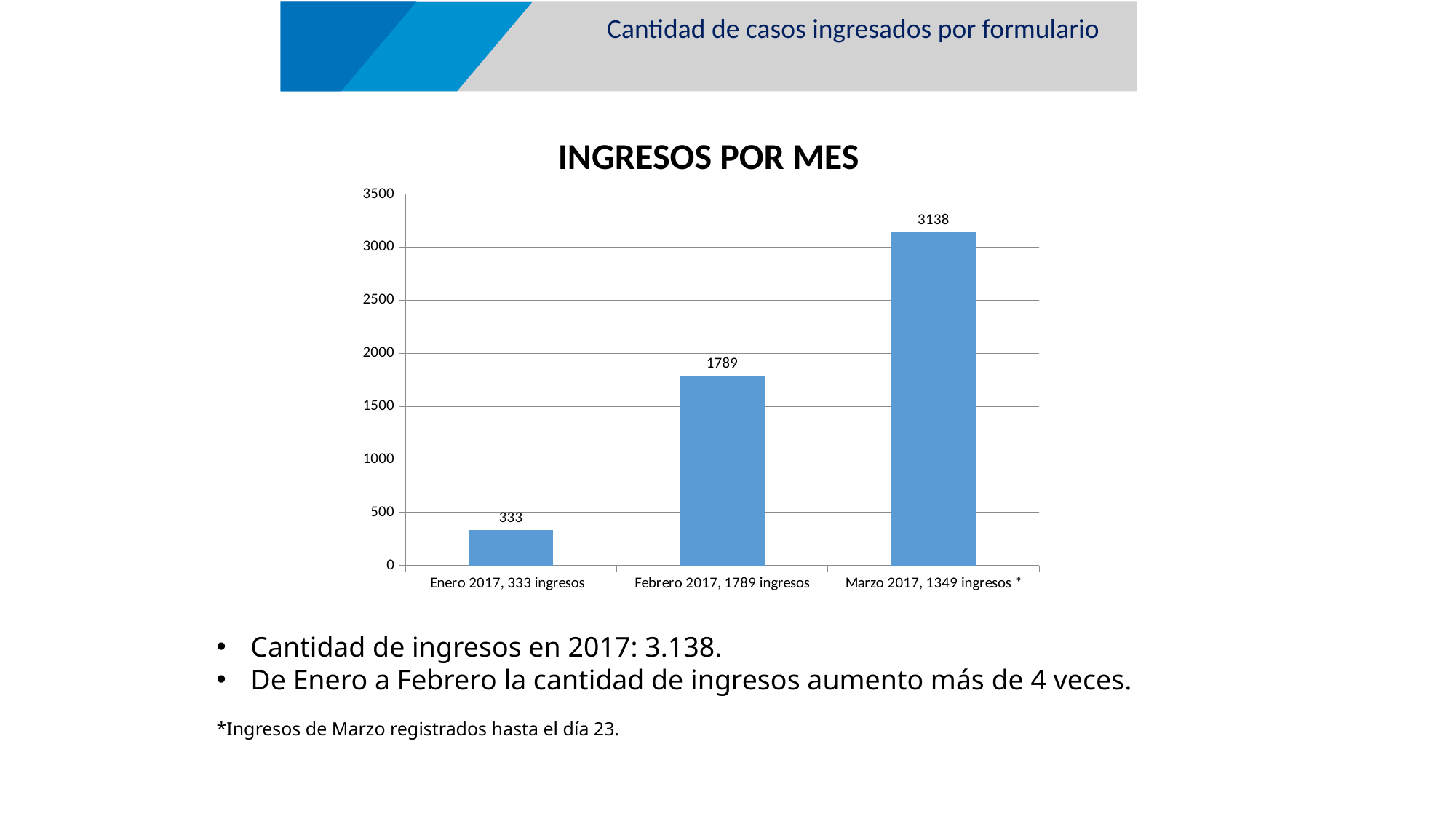
What value is shown above the bar for Enero 2017 in the INGRESOS POR MES chart? 333 Which bar is taller, Enero 2017 or Febrero 2017? Febrero 2017 How many bars are plotted in the INGRESOS POR MES chart? 3 What value is shown above the bar for Febrero 2017 in the INGRESOS POR MES chart? 1789 What is the difference between the bar values for Marzo 2017 and Febrero 2017? 1349 Do the bar values rise or fall from Enero 2017 to Marzo 2017? Rise Which month has the shortest bar in the INGRESOS POR MES chart? Enero 2017 Which month has the tallest bar in the INGRESOS POR MES chart? Marzo 2017 What value is shown above the bar for Marzo 2017 in the INGRESOS POR MES chart? 3138 Is the bar value for Marzo 2017 greater or less than 3000? greater What is the difference between the bar values for Febrero 2017 and Enero 2017? 1456 What kind of chart is INGRESOS POR MES? Bar chart